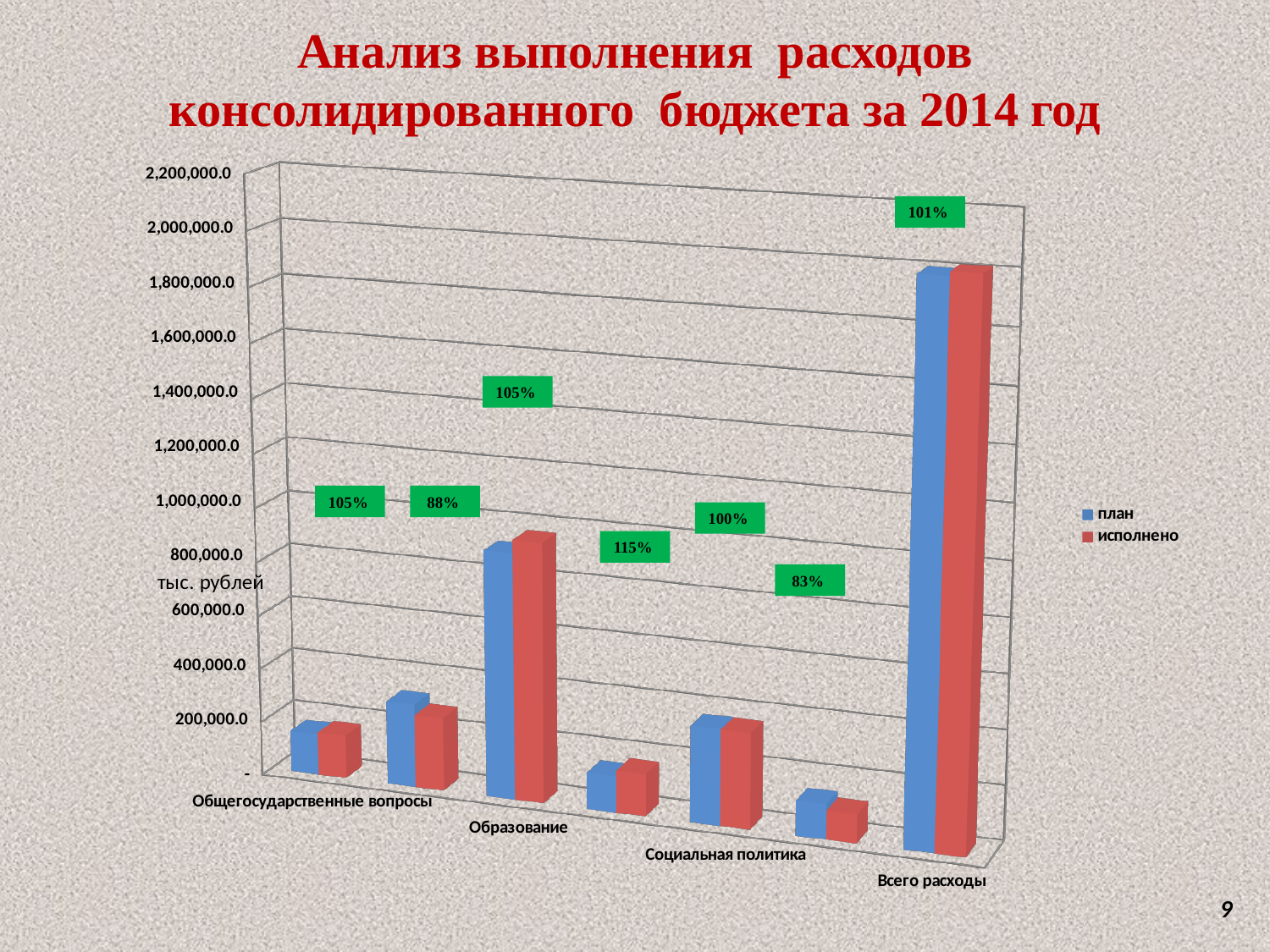
What execution percentage label is shown above the Образование bars? 105% What kind of chart is shown on the slide? bar chart Is the план value for Социальная политика greater or less than 400,000.0? less Is the план value for Образование greater or less than 600,000.0? greater Which has the larger план value, Образование or Социальная политика? Образование How many series does the legend list? 2 How many groups of bars are plotted on the chart? 7 Is the исполнено value for Образование greater or less than 1,000,000.0? less What are the two series named in the legend? план, исполнено What execution percentage label is shown above the Всего расходы bars? 101% Which category has the tallest bars? Всего расходы